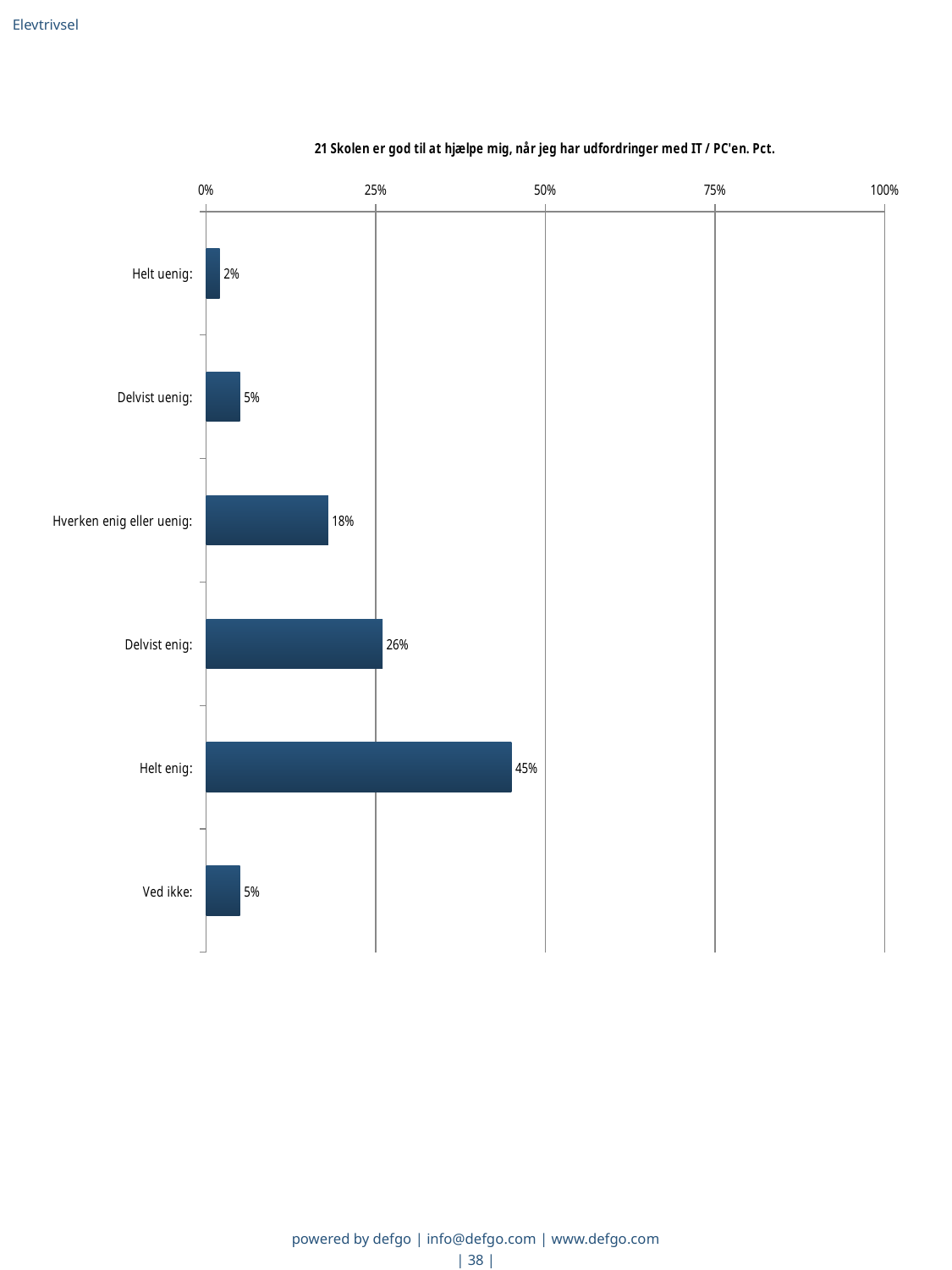
What is the value for "Helt enig"? 45% What is the difference between the values for "Helt enig" and "Delvist enig"? 19% What is the value for "Hverken enig eller uenig"? 18% Which category has the lowest value? Helt uenig What is the value for "Delvist enig"? 26% Which is larger, the value for "Hverken enig eller uenig" or the value for "Delvist enig"? Delvist enig What is the value for "Helt uenig"? 2% Is the value for "Helt enig" greater or less than 50%? less How many categories are shown on the chart? 6 Which category has the highest value? Helt enig What kind of chart is shown on the slide? bar chart What is the title of the chart? 21 Skolen er god til at hjælpe mig, når jeg har udfordringer med IT / PC'en. Pct.